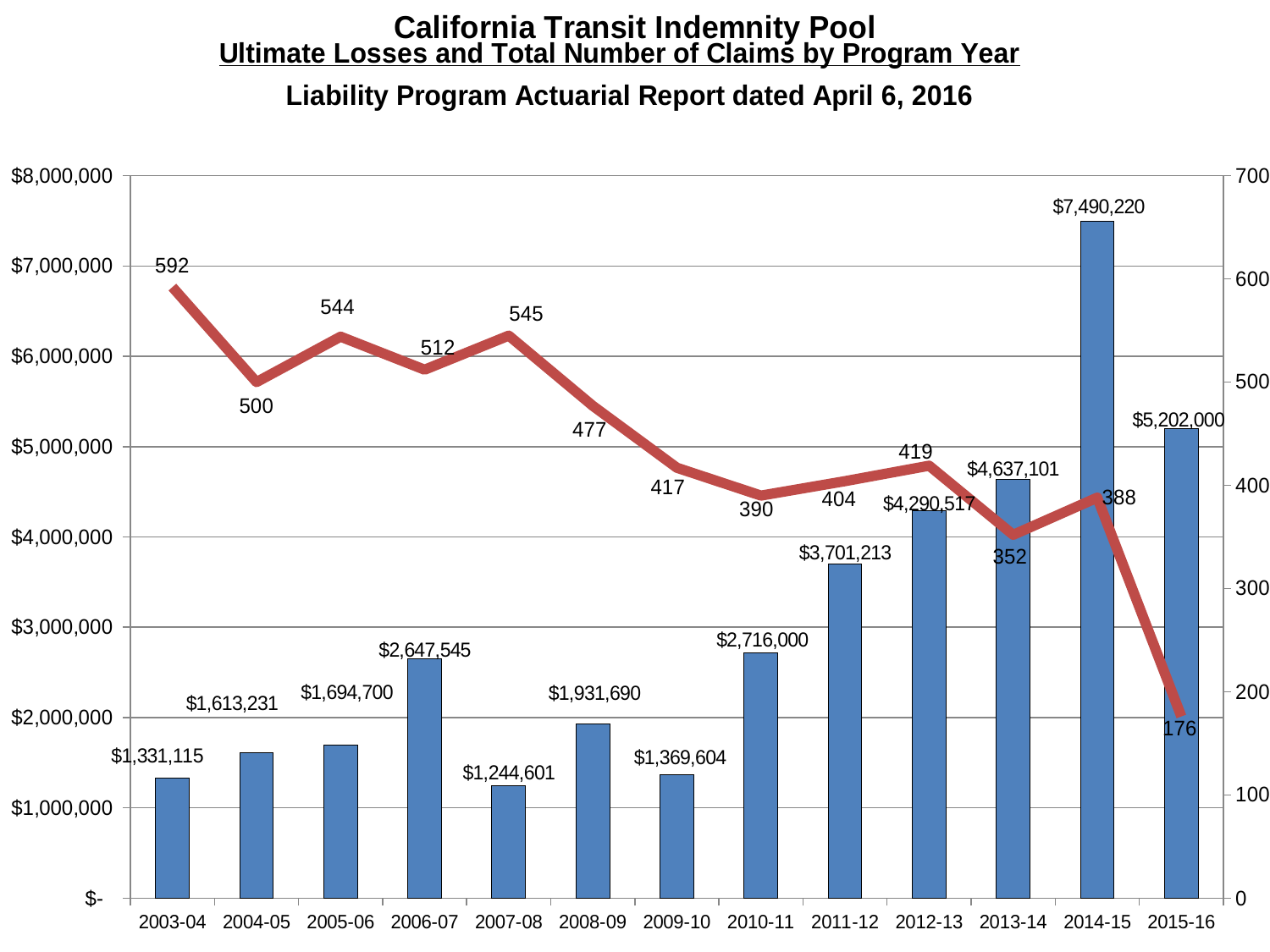
Which program year has the fewest claims? 2015-16 How many claims are shown for program year 2013-14? 352 Do the number of claims generally rise or fall from 2003-04 to 2015-16? fall How many claims are shown for program year 2003-04? 592 How many program years are shown on the x axis? 13 Which program year has higher ultimate losses, 2006-07 or 2010-11? 2010-11 What kind of chart is used to show the ultimate losses? bar chart What is the difference in ultimate losses between 2014-15 and 2015-16? $2,288,220 Which program year has the highest ultimate losses? 2014-15 How many more claims were there in 2003-04 than in 2015-16? 416 What are the ultimate losses for program year 2014-15? $7,490,220 Which program year has the lowest ultimate losses? 2007-08